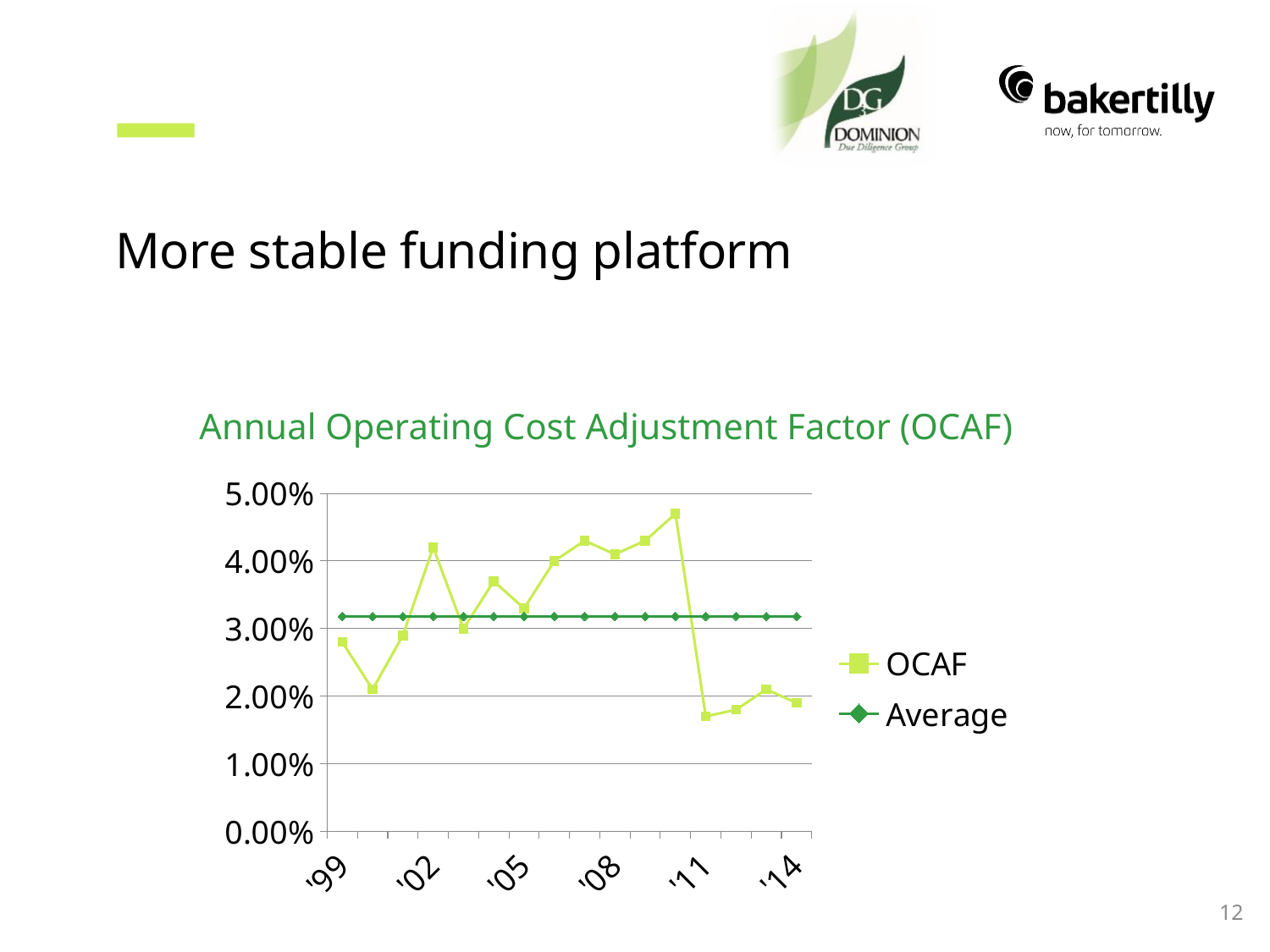
How many series does the legend list? 2 Is the Average series greater or less than 3.00%? greater What are the two series named in the legend? OCAF and Average How many data points does the OCAF series have? 16 What kind of chart is shown on the slide? line chart Which is larger, the OCAF value for '02 or the OCAF value for '11? '02 Is the OCAF value for '08 greater or less than 4.00%? greater Does the OCAF series rise or fall between '08 and '11? fall Is the OCAF value for '99 greater or less than 3.00%? less What is the title of the chart? Annual Operating Cost Adjustment Factor (OCAF)